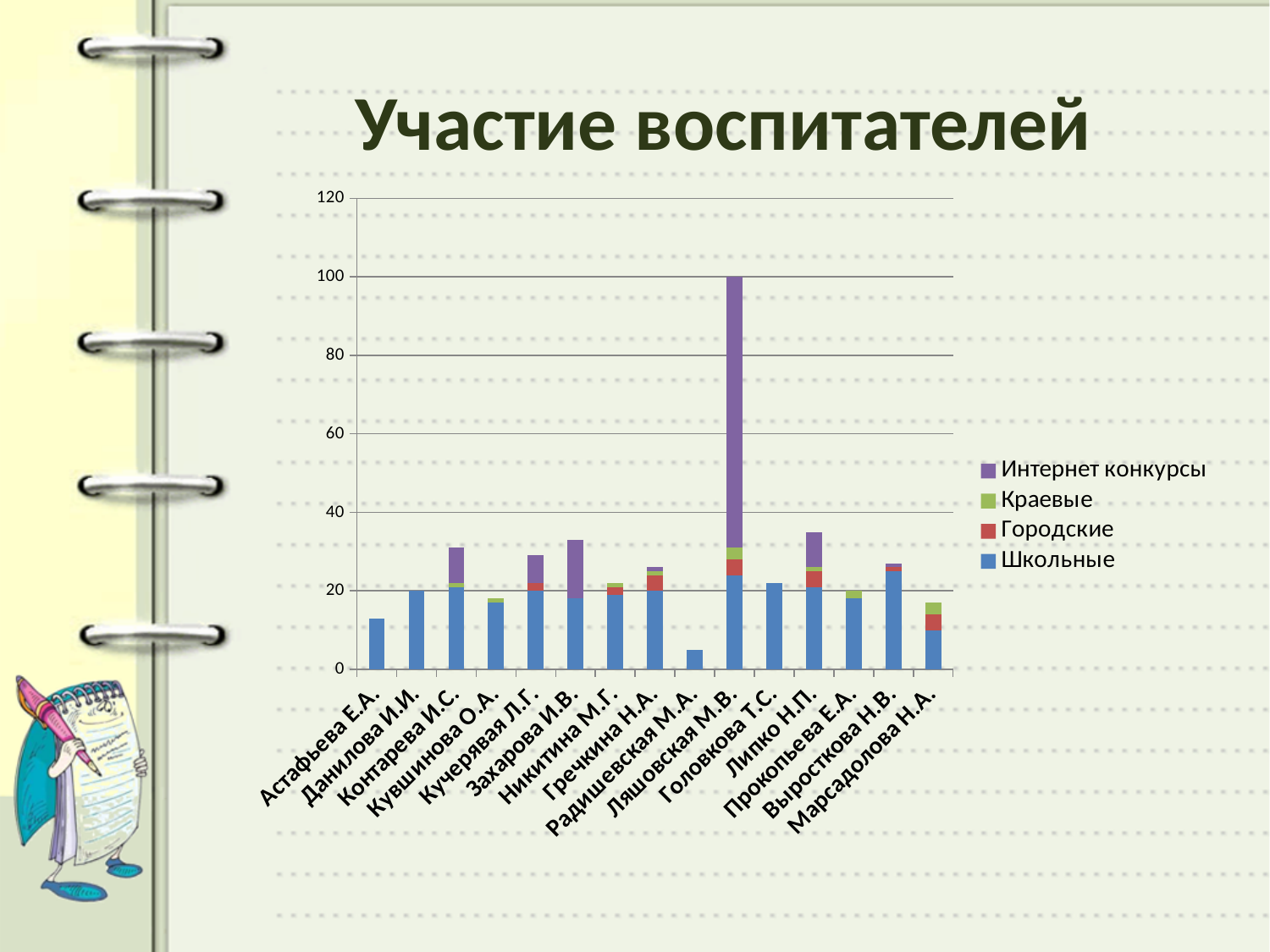
How many teachers (categories) are shown on the x axis? 15 Is the total bar for Ляшовская М.В. greater or less than 80? greater Is the total bar for Астафьева Е.А. greater or less than 20? less How many series does the legend list? 4 Whose stacked bar is taller, Захарова И.В. or Астафьева Е.А.? Захарова И.В. What is the title of the chart? Участие воспитателей Which teacher has the shortest stacked bar? Радишевская М.А. What kind of chart is shown on the slide? bar chart Which series is shown in purple in the legend? Интернет конкурсы Is the total bar for Липко Н.П. greater or less than 20? greater Which teacher has the tallest stacked bar? Ляшовская М.В.